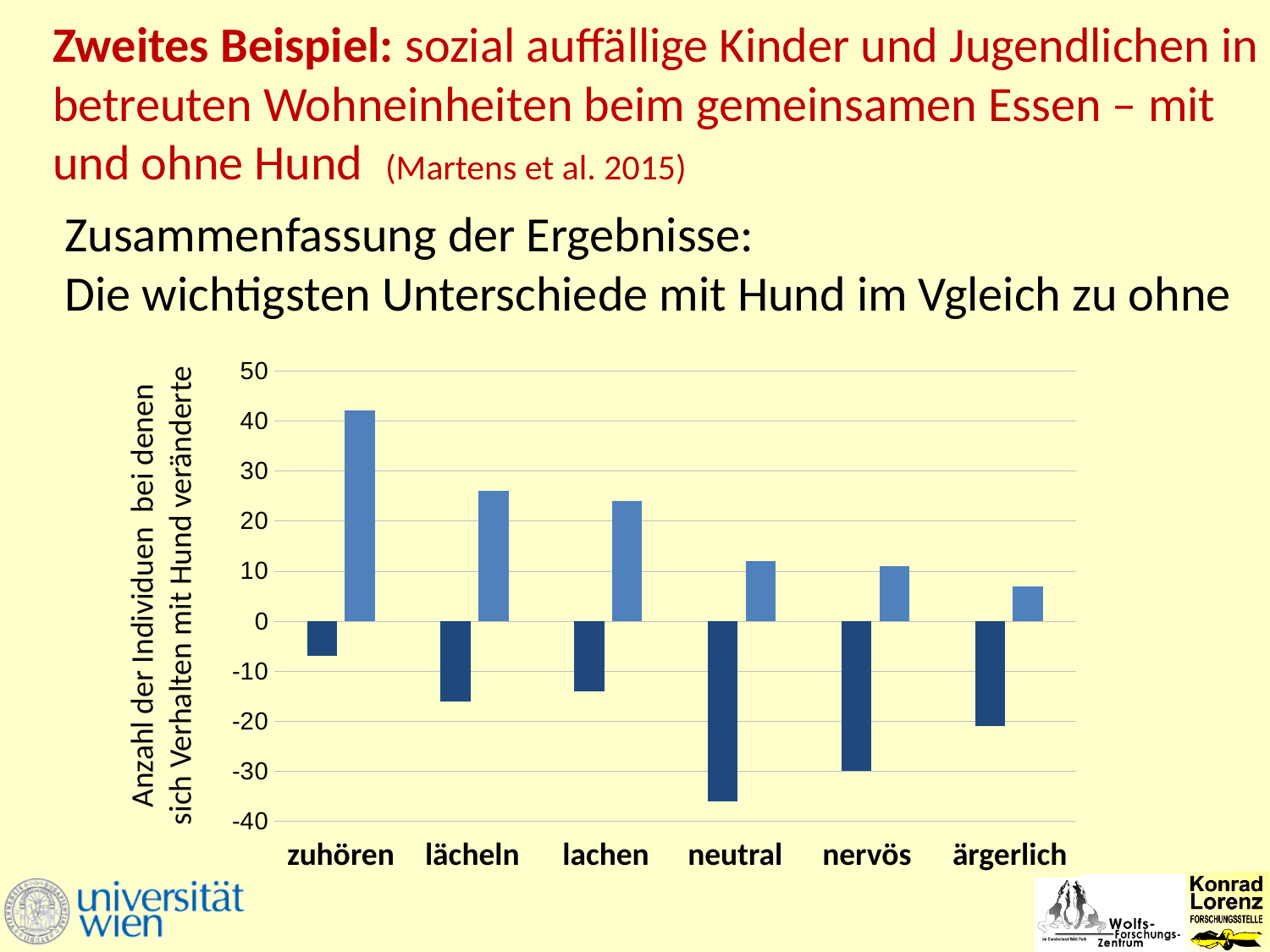
Which light blue bar is taller, zuhören or lächeln? zuhören Which category has the shortest light blue bar? ärgerlich Do the light blue bars rise or fall from left to right across the categories? fall Is the light blue bar for zuhören greater or less than 40? greater Which category has the tallest light blue bar? zuhören What kind of chart is shown on the slide? bar chart What is the label of the y axis of the chart? Anzahl der Individuen bei denen sich Verhalten mit Hund veränderte How many categories are shown on the x axis of the chart? 6 Is the dark blue bar for zuhören greater or less than -10? greater Is the light blue bar for ärgerlich greater or less than 10? less Which category has the lowest (most negative) dark blue bar? neutral